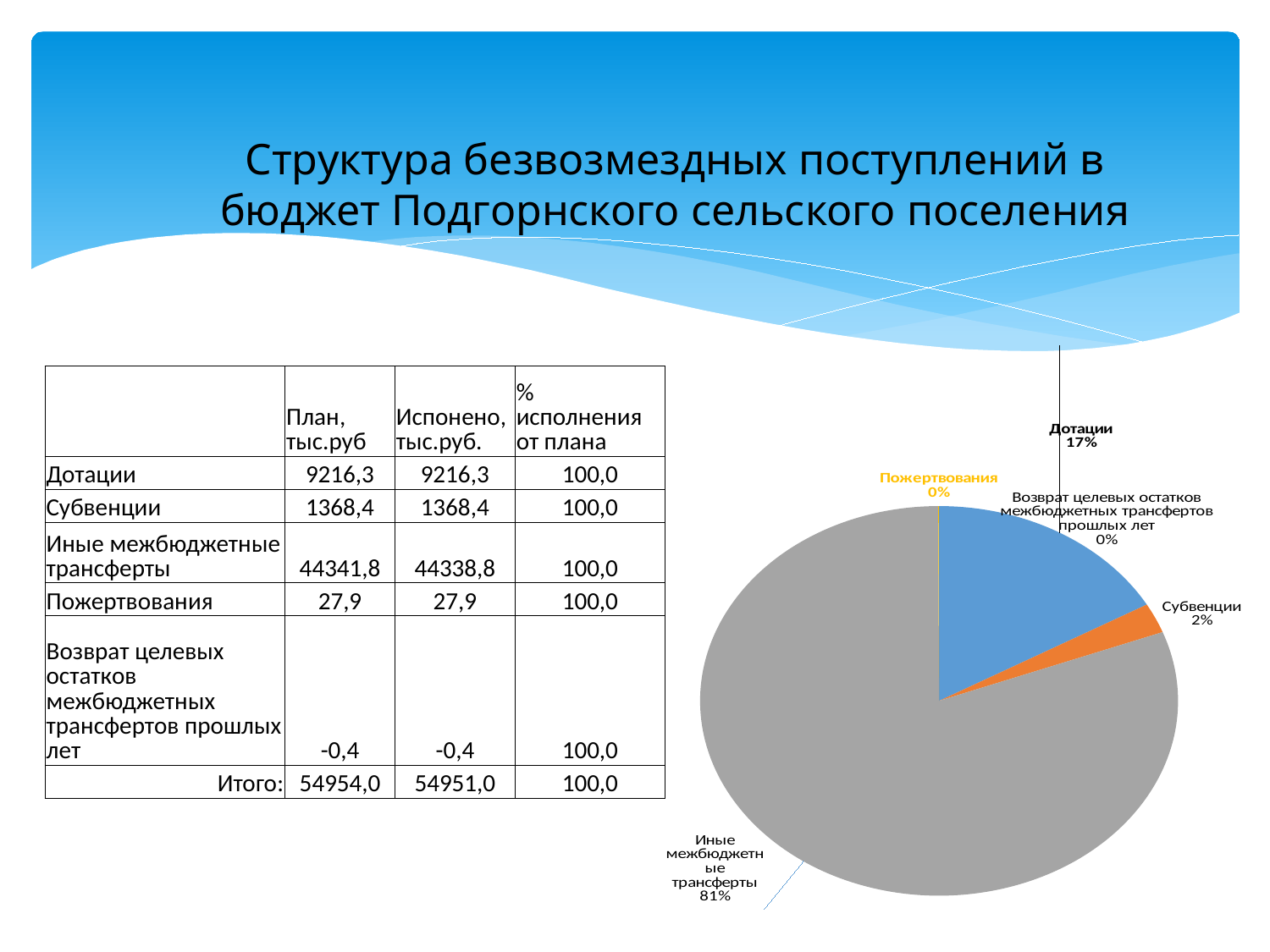
What colour is the Иные межбюджетные трансферты slice in the pie chart? grey What share of the pie does Возврат целевых остатков межбюджетных трансфертов прошлых лет have? 0% What is the difference in percentage points between the shares of Иные межбюджетные трансферты and Дотации? 64 Which is larger in the pie chart, Дотации or Субвенции? Дотации What colour is the Дотации slice in the pie chart? blue What share of the pie does Субвенции have? 2% What share of the pie does Пожертвования have? 0% What kind of chart is shown on the slide? pie chart How many slices are labelled in the pie chart? 5 Which category has the largest slice of the pie? Иные межбюджетные трансферты